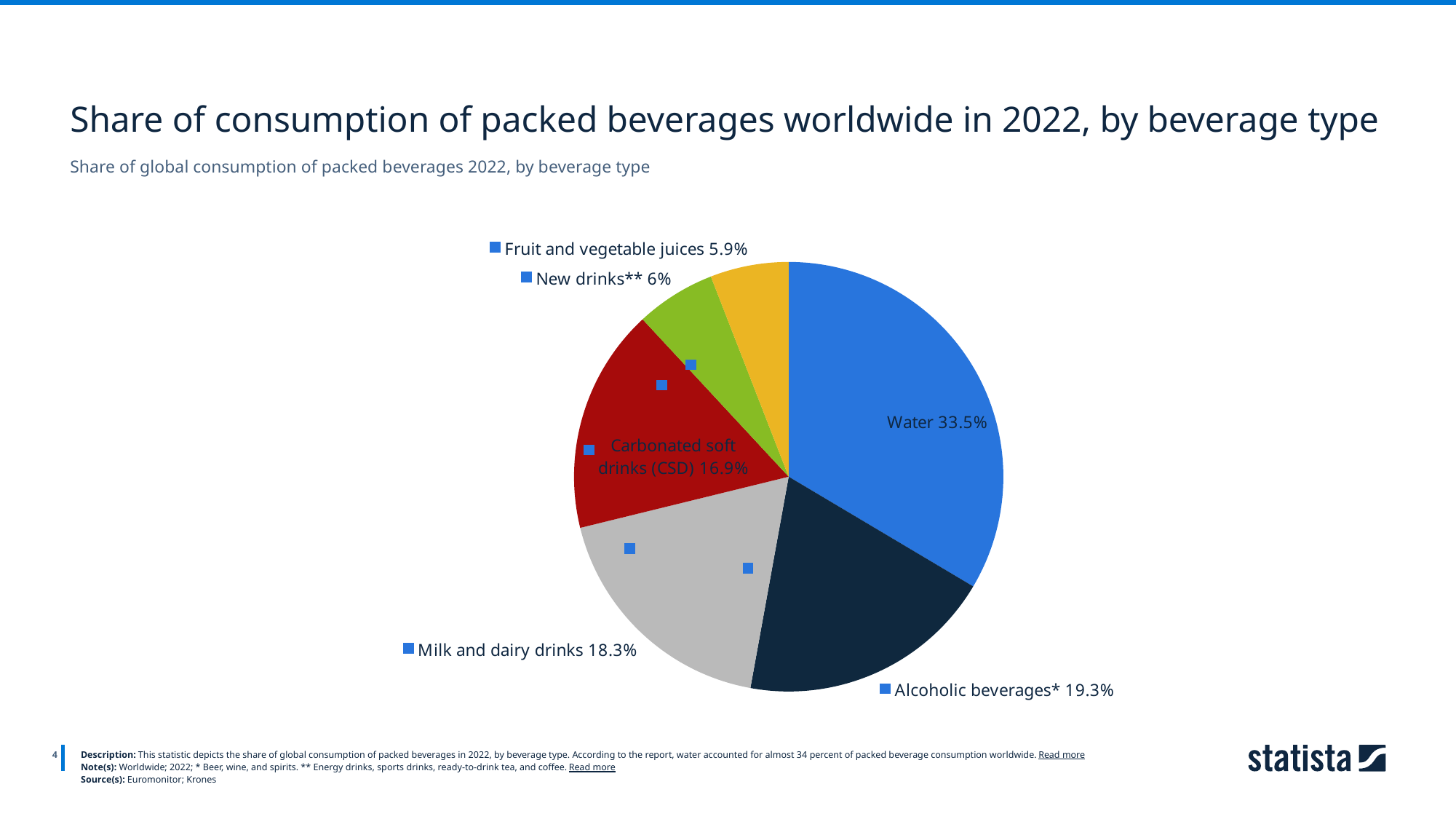
Which beverage type has the smallest share of the pie? Fruit and vegetable juices What is the share for New drinks**? 6% Which has a larger share, Milk and dairy drinks or Carbonated soft drinks (CSD)? Milk and dairy drinks What is the share for Fruit and vegetable juices? 5.9% What kind of chart is shown on the slide? Pie chart What is the share for Alcoholic beverages*? 19.3% What is the share for Milk and dairy drinks? 18.3% Which beverage type has the largest share of the pie? Water How many beverage types are shown in the pie chart? 6 What is the share for Carbonated soft drinks (CSD)? 16.9% What is the difference in share between Water and Alcoholic beverages*? 14.2% What share of packed beverage consumption does Water account for? 33.5%